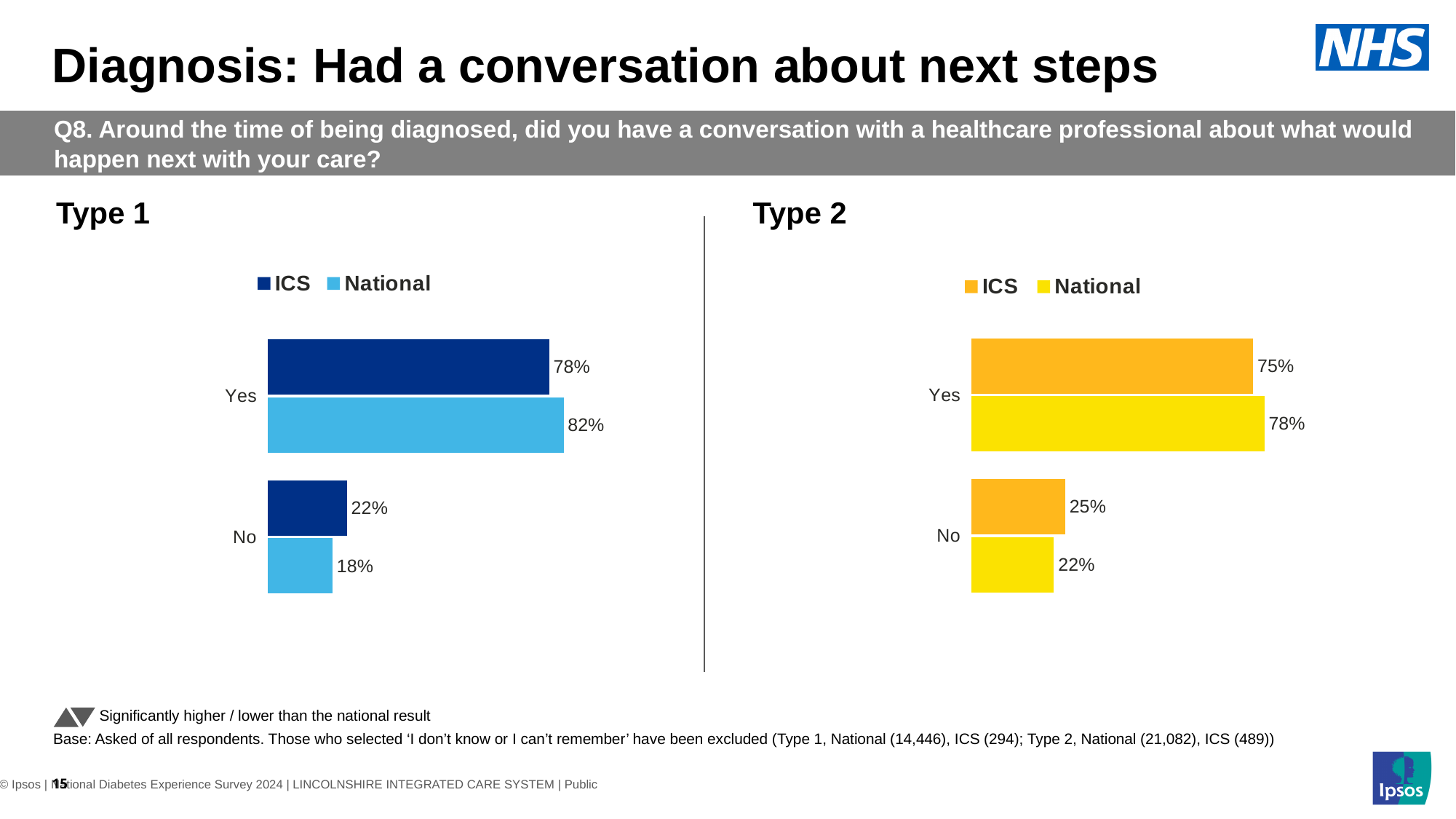
In the Type 1 chart, what is the ICS value for Yes? 78% In the Type 1 chart, what is the difference between the National and ICS values for Yes? 4 percentage points In the Type 1 chart, which response category has the highest National value? Yes How many series does the legend of the Type 2 chart list? 2 In the Type 2 chart, which response category has the lowest ICS value? No In the Type 1 chart, which is larger for No, ICS or National? ICS In the Type 2 chart, what is the National value for No? 22% In the Type 2 chart, what is the ICS value for Yes? 75% In the Type 2 chart, which is larger for Yes, ICS or National? National What kind of chart is the Type 1 chart? Bar chart In the Type 1 chart, what is the National value for No? 18% In the Type 2 chart, what is the difference between the ICS and National values for No? 3 percentage points